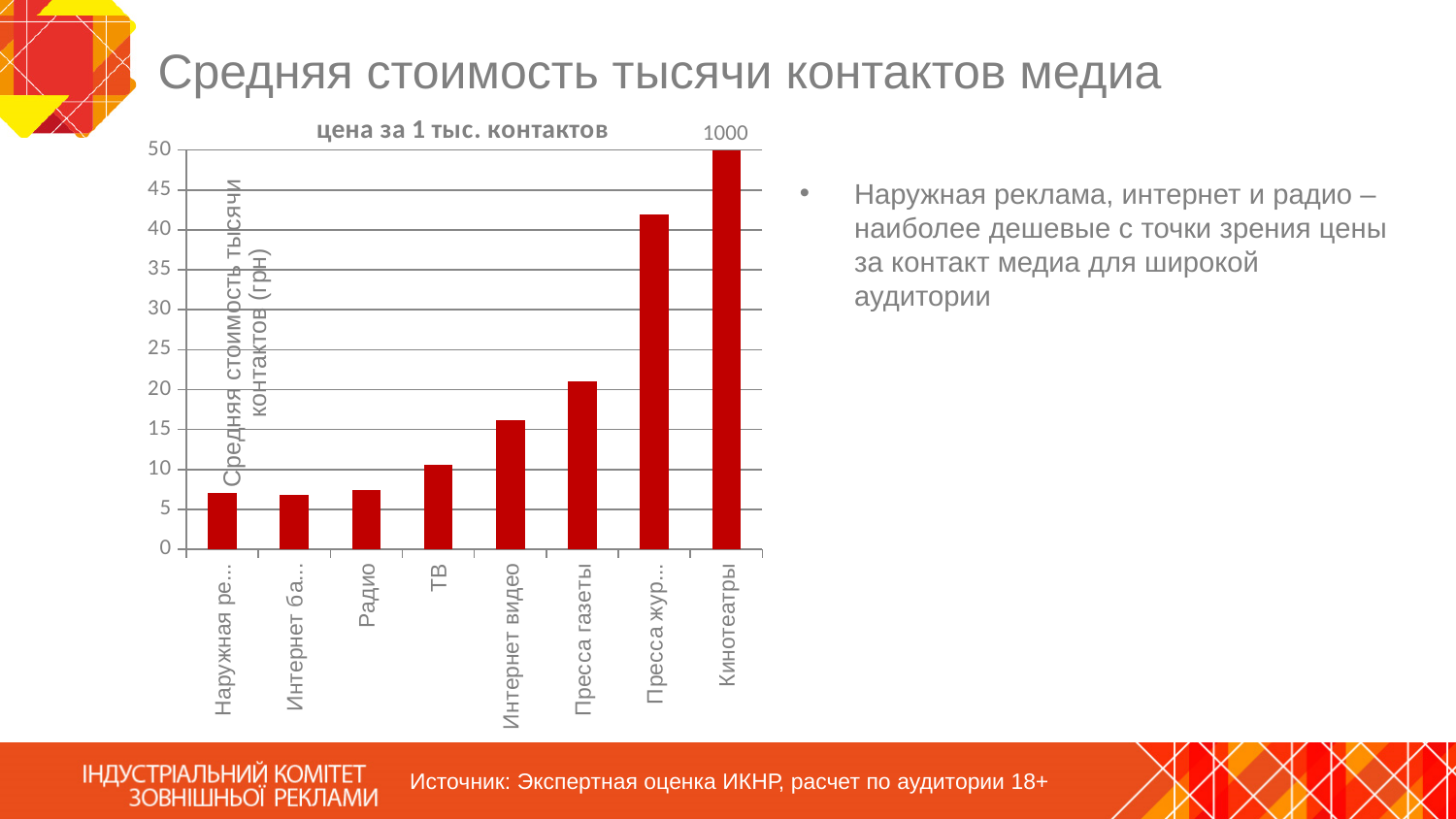
Which is larger, the value for Пресса жур... or the value for Интернет видео? Пресса жур... Which is larger, the value for Пресса газеты or the value for ТВ? Пресса газеты What kind of chart is shown on the slide? bar chart What value is labelled for Кинотеатры? 1000 What is the title of the chart? цена за 1 тыс. контактов Do the values generally rise or fall from left to right along the x axis? rise Is the value for ТВ greater or less than 15? less How many categories are plotted in the chart? 8 Is the value for Радио greater or less than 10? less Is the value for Пресса жур... greater or less than 35? greater Which category has the highest value in the chart? Кинотеатры